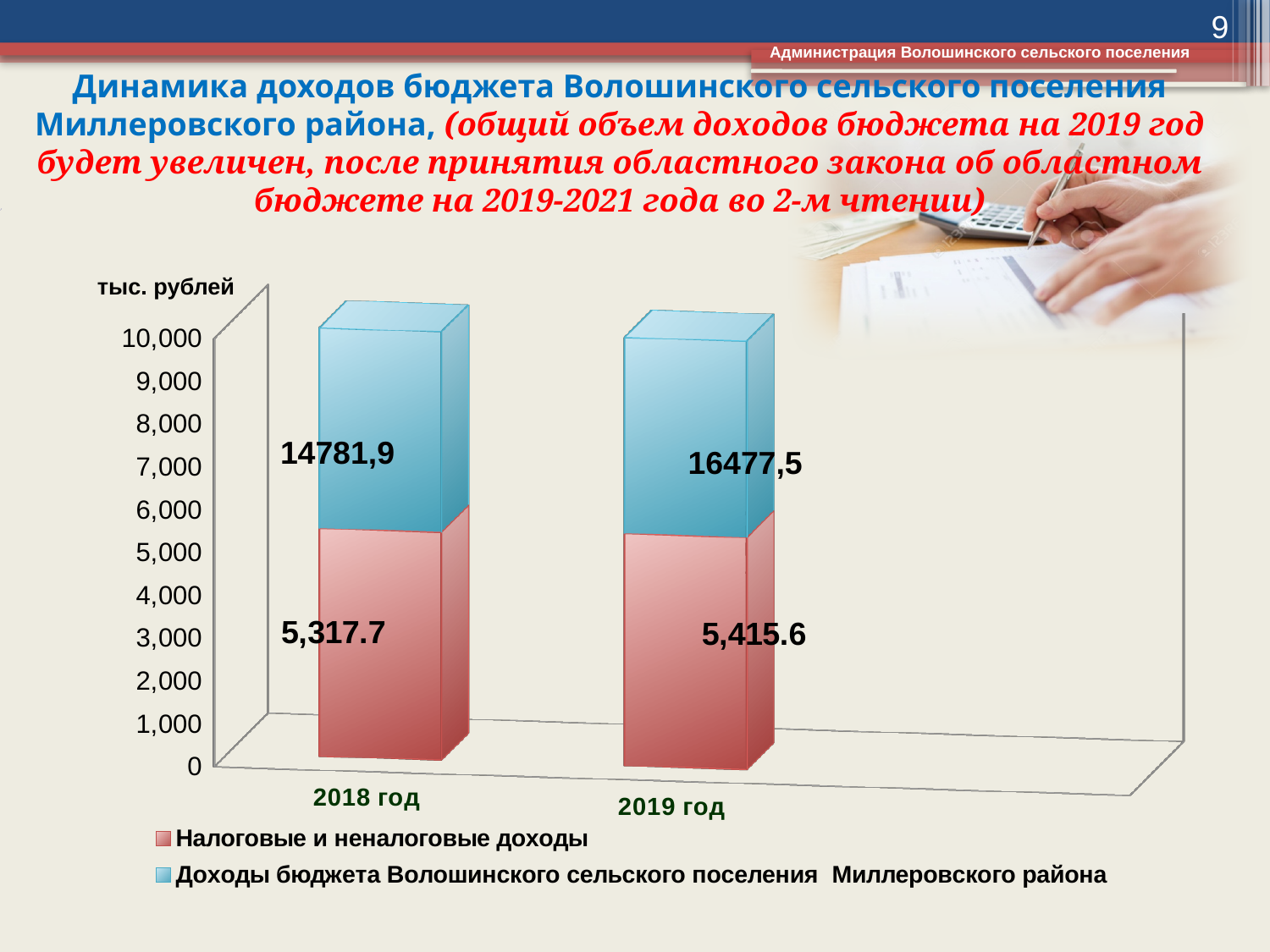
How many series does the chart legend list? 2 By how much does Налоговые и неналоговые доходы in 2019 год exceed that in 2018 год? 97.9 What value is labelled on the blue segment (Доходы бюджета Волошинского сельского поселения Миллеровского района) for 2019 год? 16477,5 What unit is indicated above the vertical axis of the chart? тыс. рублей What type of chart is shown on the slide? Stacked bar chart What value is labelled on the blue segment (Доходы бюджета Волошинского сельского поселения Миллеровского района) for 2018 год? 14781,9 What is the value of Налоговые и неналоговые доходы for 2018 год? 5,317.7 Which year has the higher value for Налоговые и неналоговые доходы? 2019 год Which year has the lower labelled value for Доходы бюджета Волошинского сельского поселения Миллеровского района? 2018 год What is the value of Налоговые и неналоговые доходы for 2019 год? 5,415.6 How many years (categories) are shown on the x axis of the chart? 2 Is the labelled value for Доходы бюджета Волошинского сельского поселения Миллеровского района larger in 2018 год or 2019 год? 2019 год